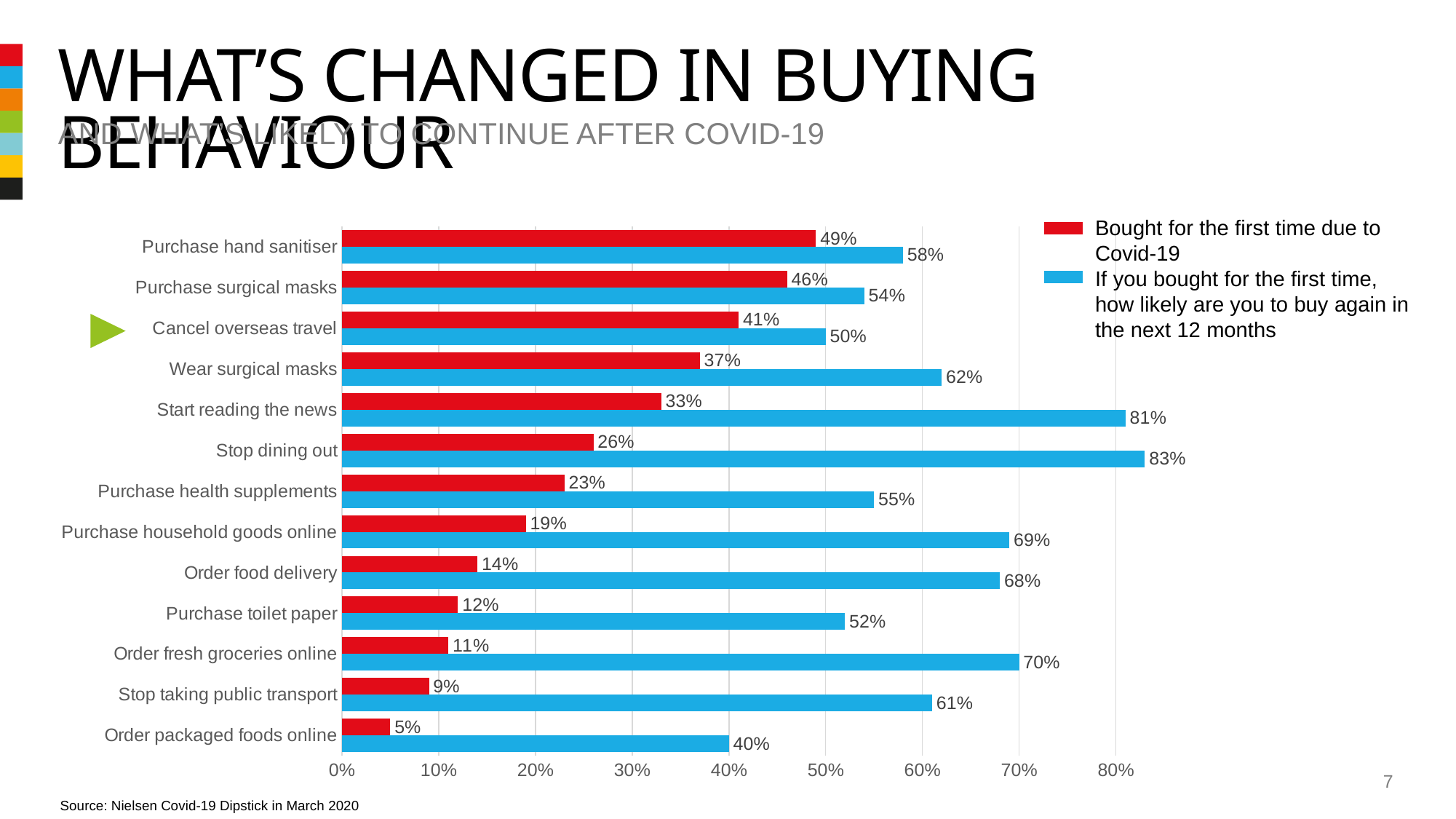
How many series does the legend list? 2 What is the difference between the two values shown for 'Start reading the news'? 48% Which category has the lowest value for 'Bought for the first time due to Covid-19'? Order packaged foods online Is the 'Bought for the first time due to Covid-19' value for 'Wear surgical masks' greater or less than 40%? less How many categories are shown on the chart? 13 What percentage bought hand sanitiser for the first time due to Covid-19? 49% Which category has the highest value for 'Bought for the first time due to Covid-19'? Purchase hand sanitiser Which category has the lowest value for likelihood to buy again in the next 12 months? Order packaged foods online What colour represents 'Bought for the first time due to Covid-19' in the chart? Red For 'Stop dining out', what is the value for 'If you bought for the first time, how likely are you to buy again in the next 12 months'? 83% What kind of chart is shown on the slide? Bar chart Which is larger: the 'buy again in the next 12 months' value for 'Order fresh groceries online' or for 'Purchase toilet paper'? Order fresh groceries online